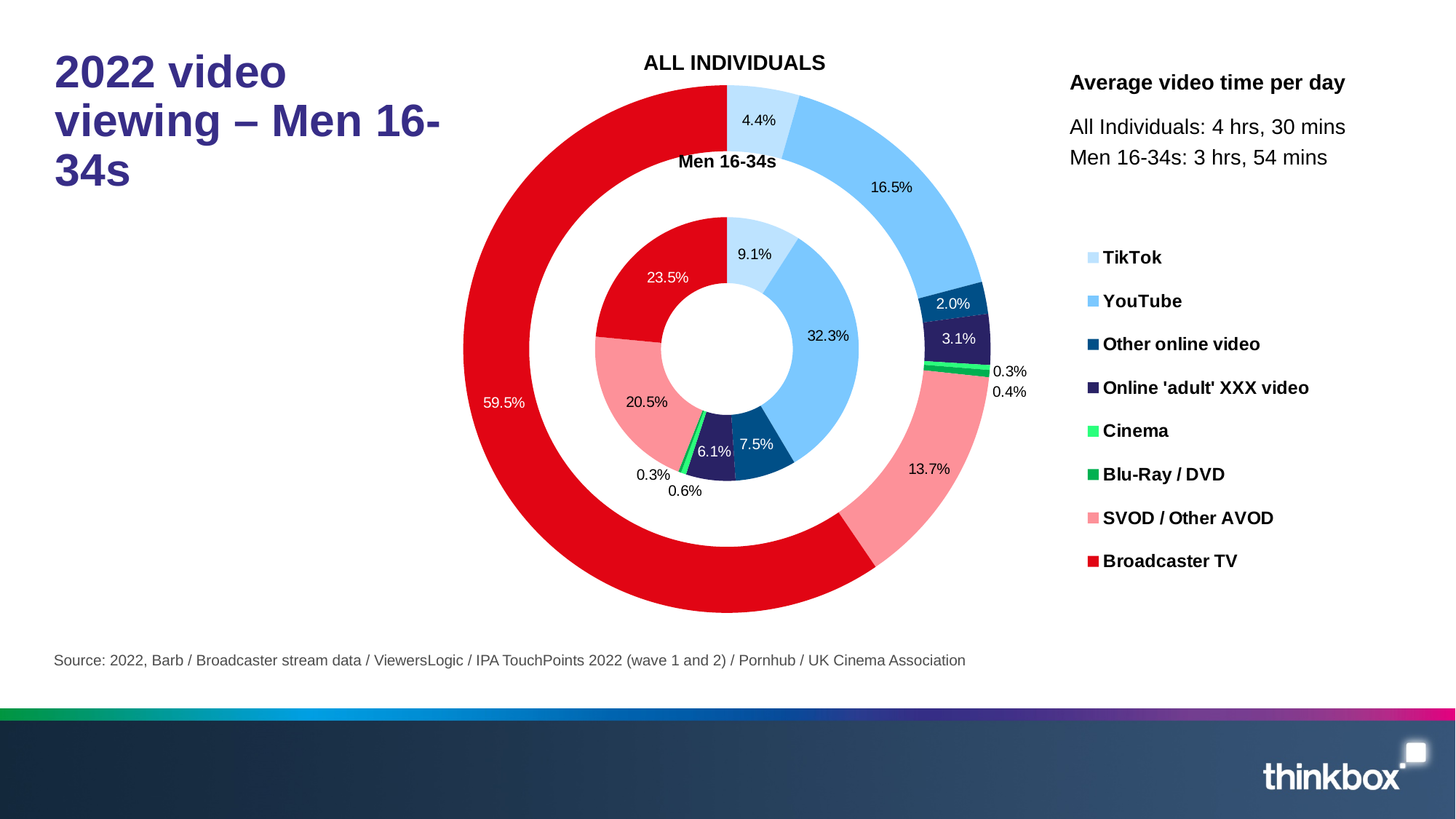
What share of video viewing for All Individuals is SVOD / Other AVOD? 13.7% Which is larger for Men 16-34s: the share for Other online video or the share for Online 'adult' XXX video? Other online video What is the difference between the Broadcaster TV share for All Individuals and for Men 16-34s? 36 percentage points What share of video viewing for All Individuals is Broadcaster TV? 59.5% Which category has the largest share for All Individuals? Broadcaster TV What share of video viewing for Men 16-34s is TikTok? 9.1% What kind of chart is shown on the slide? Doughnut chart What share of video viewing for Men 16-34s is Broadcaster TV? 23.5% How many categories does the legend list? 8 Which category has the largest share for Men 16-34s? YouTube According to the text on the slide, what is the average video time per day for Men 16-34s? 3 hrs, 54 mins What share of video viewing for Men 16-34s is YouTube? 32.3%